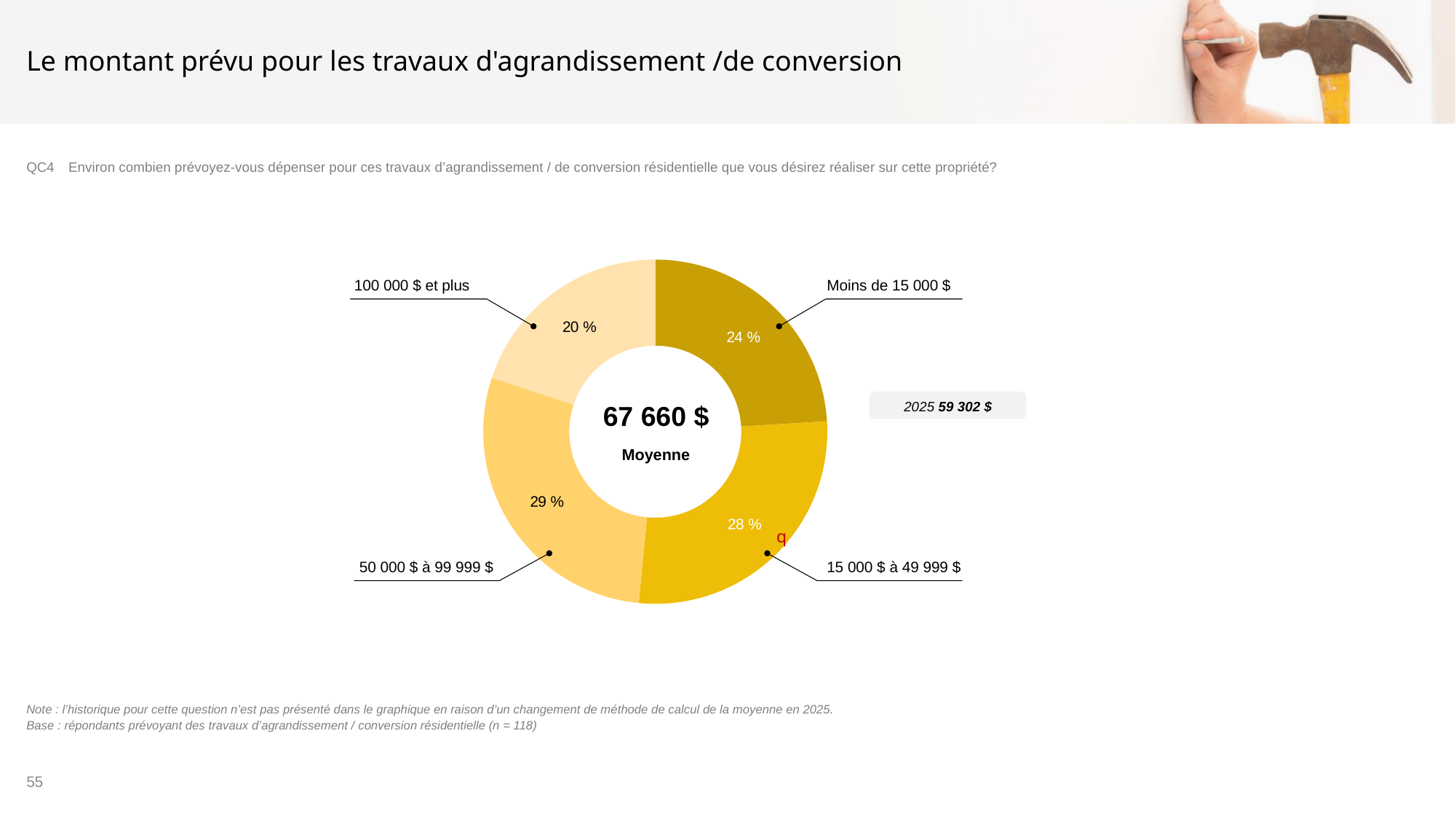
What share of respondents plan to spend 15 000 $ à 49 999 $? 28 % What 2025 value is shown in the box to the right of the chart? 59 302 $ Which is larger: the share for Moins de 15 000 $ or the share for 15 000 $ à 49 999 $? 15 000 $ à 49 999 $ What kind of chart is used on this slide? Doughnut (pie) chart What share of respondents plan to spend 100 000 $ et plus? 20 % What share of respondents plan to spend 50 000 $ à 99 999 $? 29 % What average amount (Moyenne) is shown in the centre of the chart? 67 660 $ What is the difference in percentage points between the 50 000 $ à 99 999 $ slice and the 100 000 $ et plus slice? 9 Which spending category has the largest share? 50 000 $ à 99 999 $ Which spending category has the smallest share? 100 000 $ et plus How many spending categories are shown in the chart? 4 What share of respondents plan to spend less than 15 000 $ (Moins de 15 000 $)? 24 %